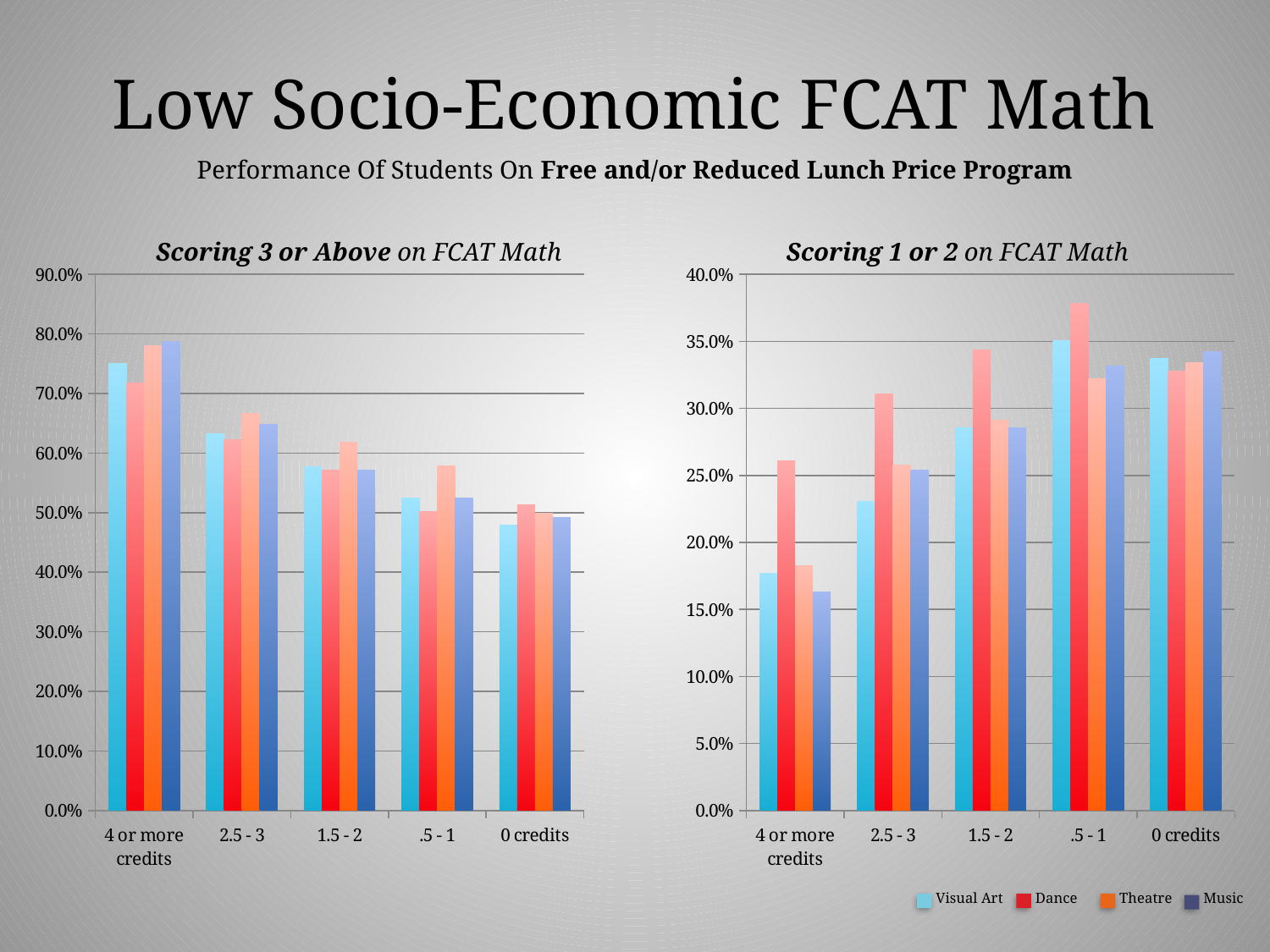
In the 'Scoring 3 or Above on FCAT Math' chart, which series has the highest bar for '.5 - 1'? Theatre In the 'Scoring 1 or 2 on FCAT Math' chart, for '4 or more credits', is the Dance bar or the Visual Art bar larger? Dance In the 'Scoring 1 or 2 on FCAT Math' chart, is the Dance value for '.5 - 1' greater or less than 35.0%? greater How many credit categories are shown on the x axis of the 'Scoring 1 or 2 on FCAT Math' chart? 5 What kind of chart is the 'Scoring 3 or Above on FCAT Math' chart? bar chart In the 'Scoring 1 or 2 on FCAT Math' chart, which credit category has the lowest Music bar? 4 or more credits In the 'Scoring 1 or 2 on FCAT Math' chart, do the Music bars rise or fall from '4 or more credits' to '0 credits'? rise In the 'Scoring 3 or Above on FCAT Math' chart, is the Dance value for '0 credits' greater or less than 60.0%? less In the 'Scoring 3 or Above on FCAT Math' chart, is the Visual Art value for '4 or more credits' greater or less than 70.0%? greater In the 'Scoring 1 or 2 on FCAT Math' chart, which credit category has the highest Dance bar? .5 - 1 In the 'Scoring 3 or Above on FCAT Math' chart, do the Visual Art bars rise or fall from '4 or more credits' to '0 credits'? fall How many series does the legend list for the charts on this slide? 4